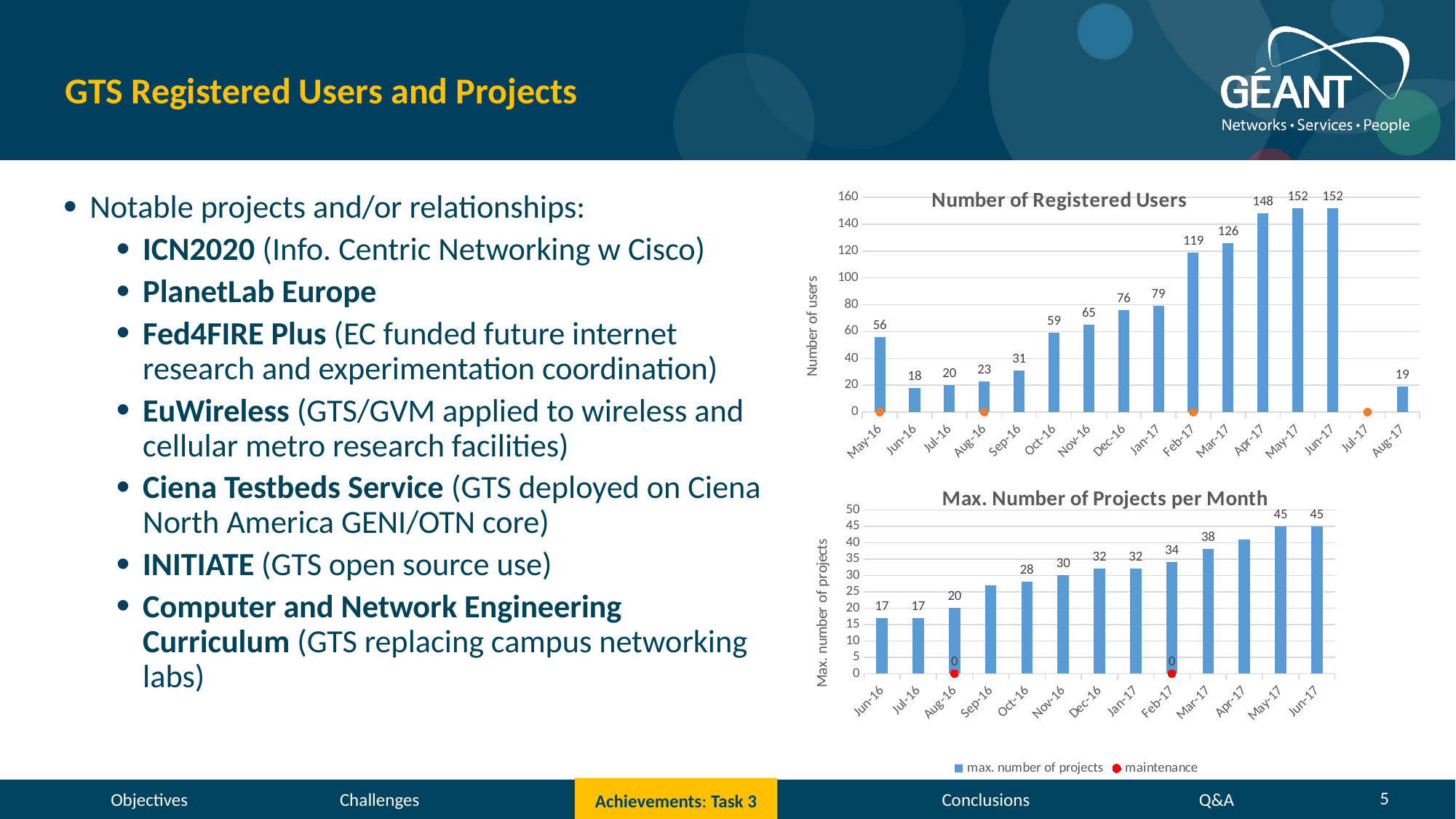
In the Max. Number of Projects per Month chart, how many series does the legend list? 2 In the Number of Registered Users chart, what is the difference between the values for Apr-17 and Mar-17? 22 In the Number of Registered Users chart, which month has the lowest number of users among the months with a bar? Jun-16 In the Max. Number of Projects per Month chart, which months have the highest value? May-17 and Jun-17 In the Max. Number of Projects per Month chart, what is the value for Mar-17? 38 In the Number of Registered Users chart, what is the value for Aug-17? 19 What kind of chart is the Max. Number of Projects per Month chart? bar chart In the Max. Number of Projects per Month chart, is the value for Sep-16 greater or less than 25? greater In the Number of Registered Users chart, what is the value for Feb-17? 119 In the Number of Registered Users chart, which is larger, the value for May-16 or the value for Oct-16? Oct-16 In the Max. Number of Projects per Month chart, do the values generally rise or fall from Jun-16 to Jun-17? rise In the Number of Registered Users chart, how many months are shown on the x axis? 16